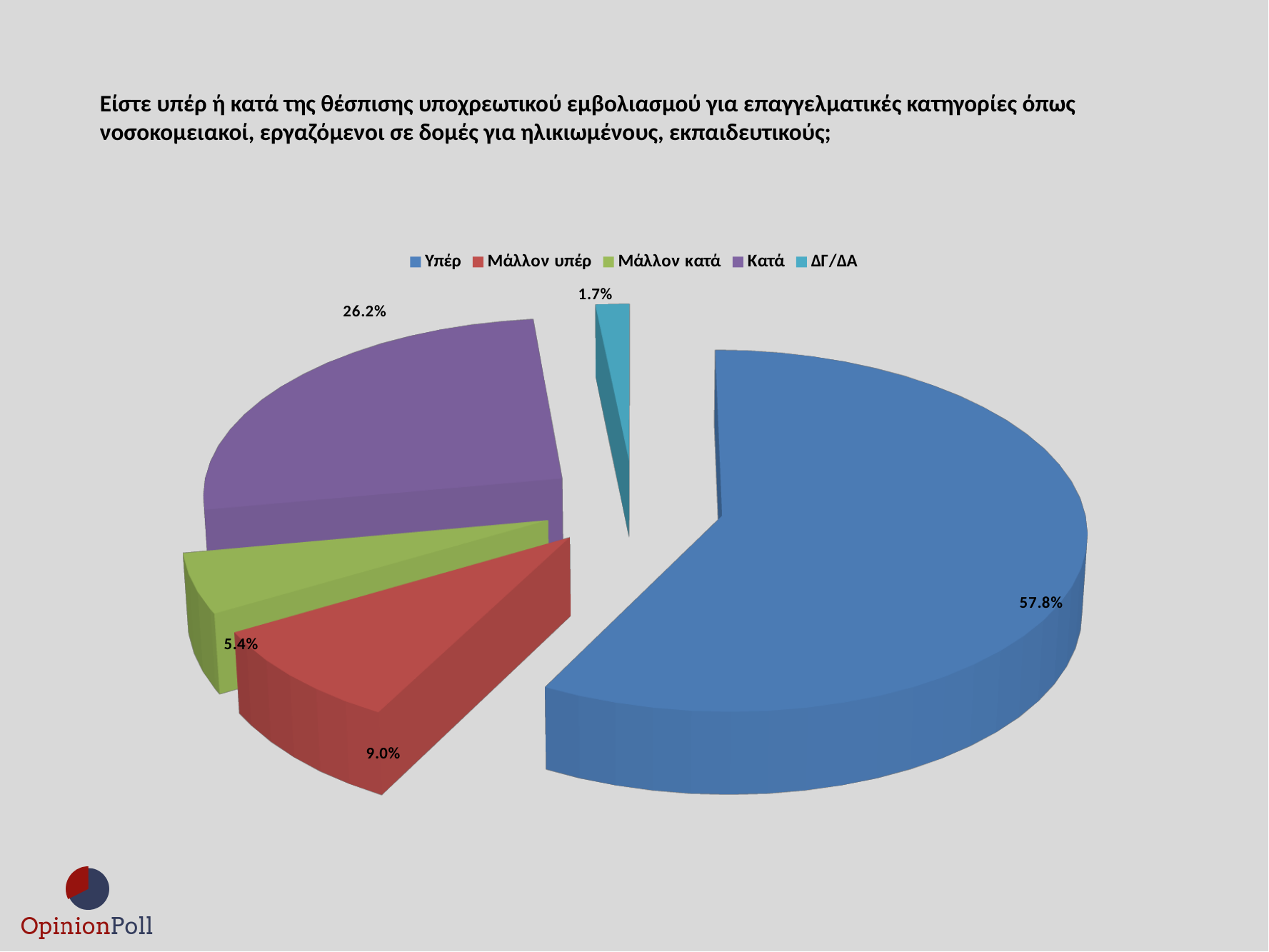
How many categories does the legend list? 5 What percentage is shown for Υπέρ? 57.8% What percentage is shown for ΔΓ/ΔΑ? 1.7% Which category has the smallest slice of the pie? ΔΓ/ΔΑ What percentage is shown for Κατά? 26.2% What kind of chart is shown on the slide? Pie chart What is the difference in percentage points between Υπέρ and Κατά? 31.6 Which category has the largest slice of the pie? Υπέρ What colour is the slice for Κατά? Purple Which is larger, Μάλλον υπέρ or Μάλλον κατά? Μάλλον υπέρ What percentage is shown for Μάλλον υπέρ? 9.0% What percentage is shown for Μάλλον κατά? 5.4%